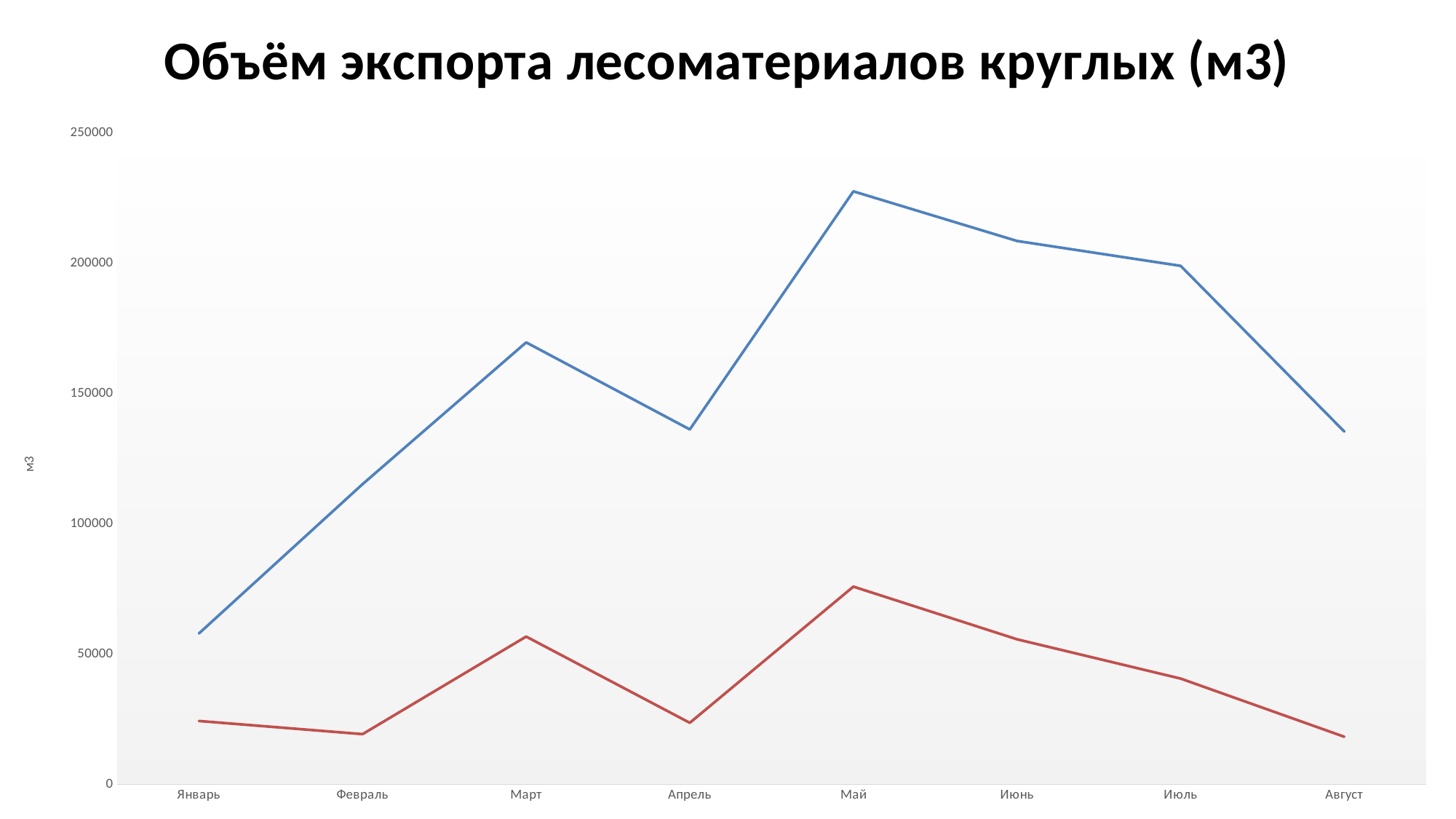
Which is larger for the red line: the value for Март or the value for Январь? Март In which month does the red line reach its highest value? Май Is the value of the blue line for Май greater or less than 200000? greater In which month does the blue line reach its highest value? Май Does the blue line rise or fall from Май to Август? fall What is the title of the chart? Объём экспорта лесоматериалов круглых (м3) In which month does the blue line have its lowest value? Январь What kind of chart is shown on the slide? line chart Is the value of the blue line for Август greater or less than 150000? less Is the value of the red line for Май greater or less than 50000? greater How many months are shown along the x axis? 8